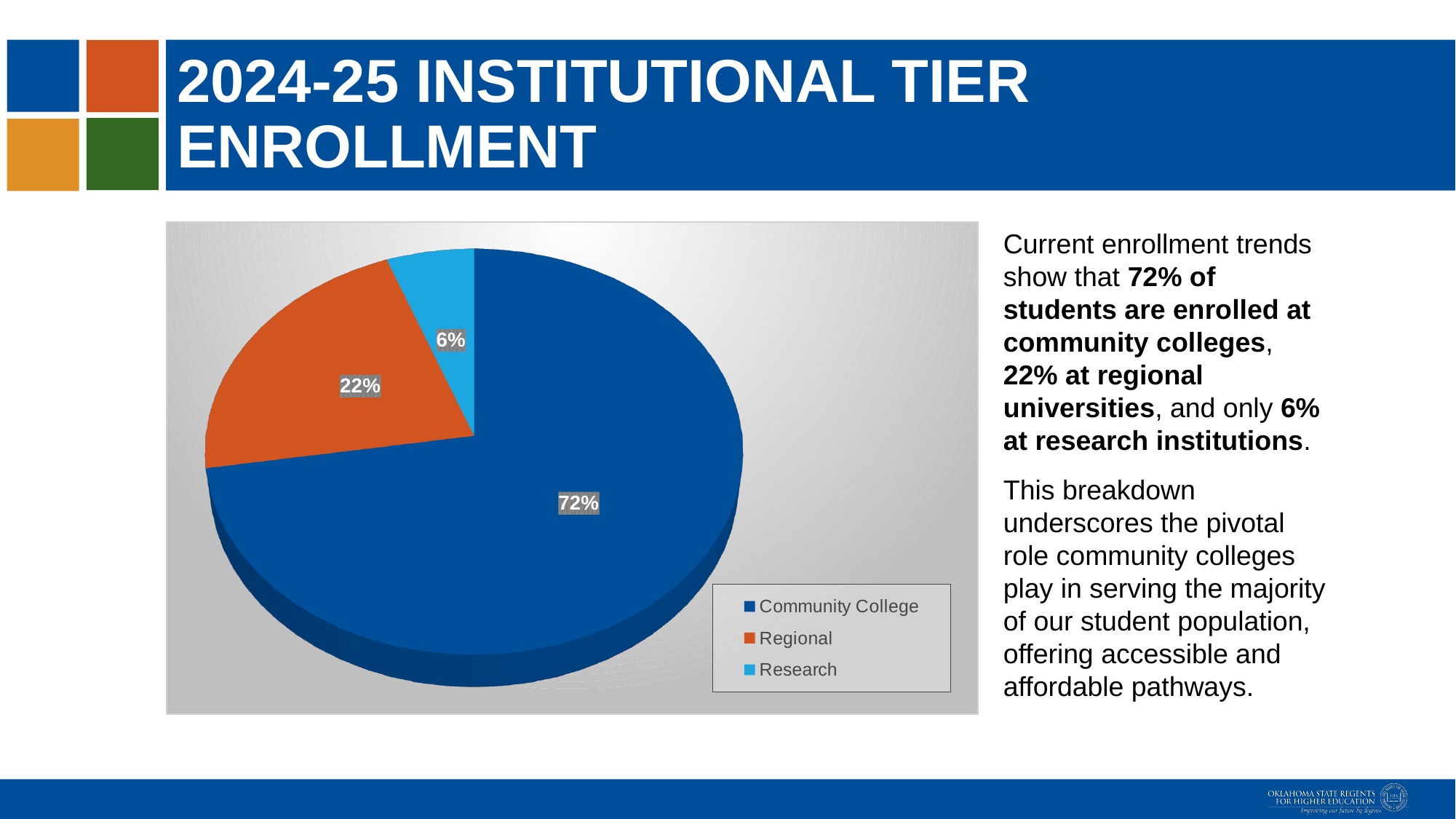
What share of enrollment is at Research institutions? 6% Which institutional tier has the largest share of enrollment? Community College What kind of chart is shown on the slide? Pie chart What colour is the Regional slice? Orange What is the difference in percentage points between the Community College and Regional shares? 50 How many entries does the legend list? 3 Which has a larger share, Regional or Research? Regional What is the difference in percentage points between the Regional and Research shares? 16 What share of enrollment is at Community College? 72% Which institutional tier has the smallest share of enrollment? Research How many slices does the pie chart have? 3 What share of enrollment is at Regional institutions? 22%